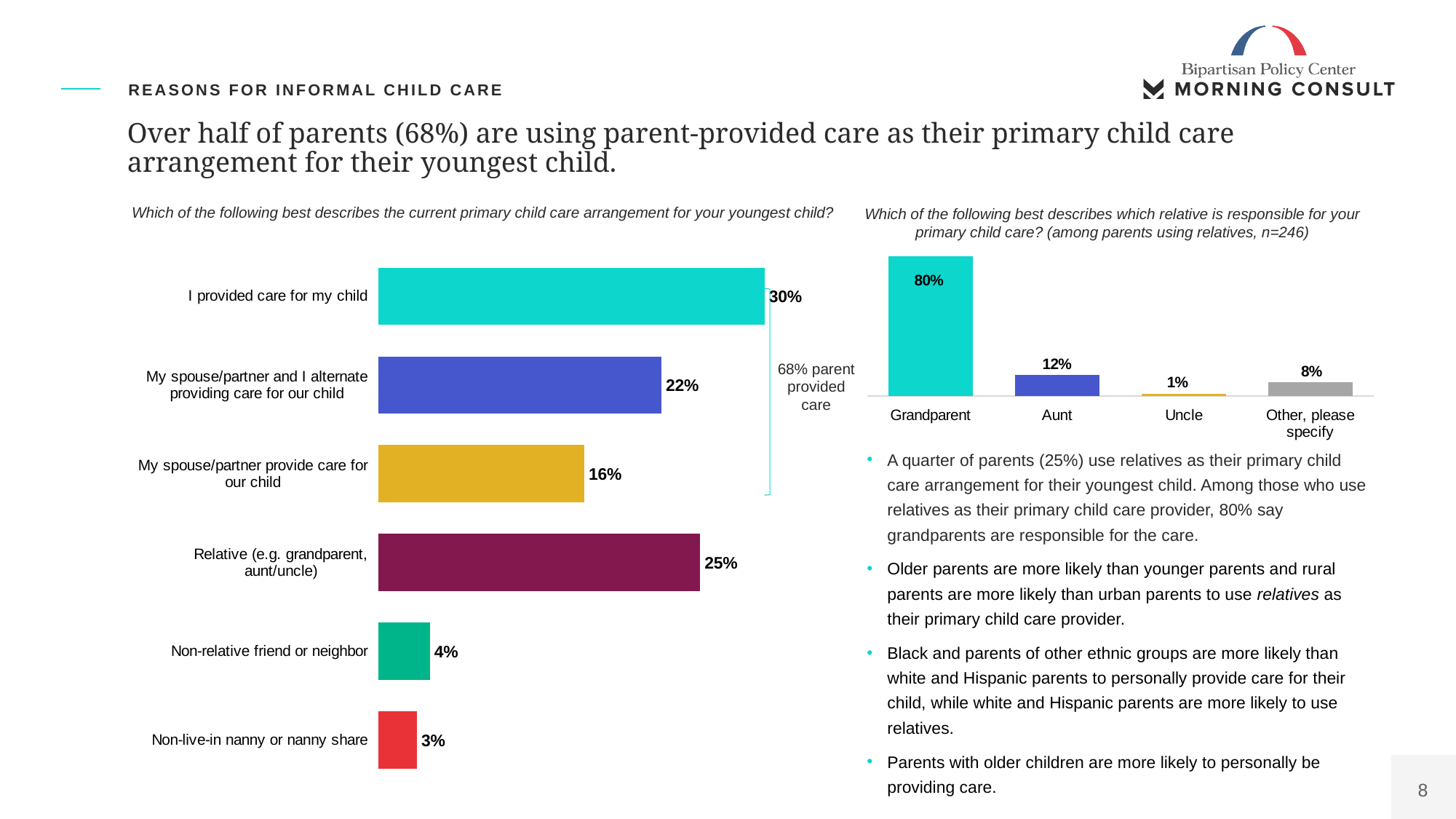
In the right chart on which relative is responsible for primary child care, what is the value for Uncle? 1% In the left chart on primary child care arrangement, what label is shown next to the bracket grouping the top three bars? 68% parent provided care What kind of chart is the right chart on which relative is responsible for primary child care? Bar chart In the left chart on primary child care arrangement, which category has the highest value? I provided care for my child In the right chart on which relative is responsible for primary child care, what is the value for Grandparent? 80% In the left chart on primary child care arrangement, what is the value for 'Relative (e.g. grandparent, aunt/uncle)'? 25% In the left chart on primary child care arrangement, which category has the lowest value? Non-live-in nanny or nanny share In the right chart on which relative is responsible for primary child care, what is the difference between Grandparent and Aunt? 68% In the left chart on primary child care arrangement, how many categories are shown? 6 In the right chart on which relative is responsible for primary child care, which is larger: Aunt or 'Other, please specify'? Aunt In the left chart on primary child care arrangement, what is the value for 'I provided care for my child'? 30% In the left chart on primary child care arrangement, what is the difference between 'My spouse/partner and I alternate providing care for our child' and 'My spouse/partner provide care for our child'? 6%